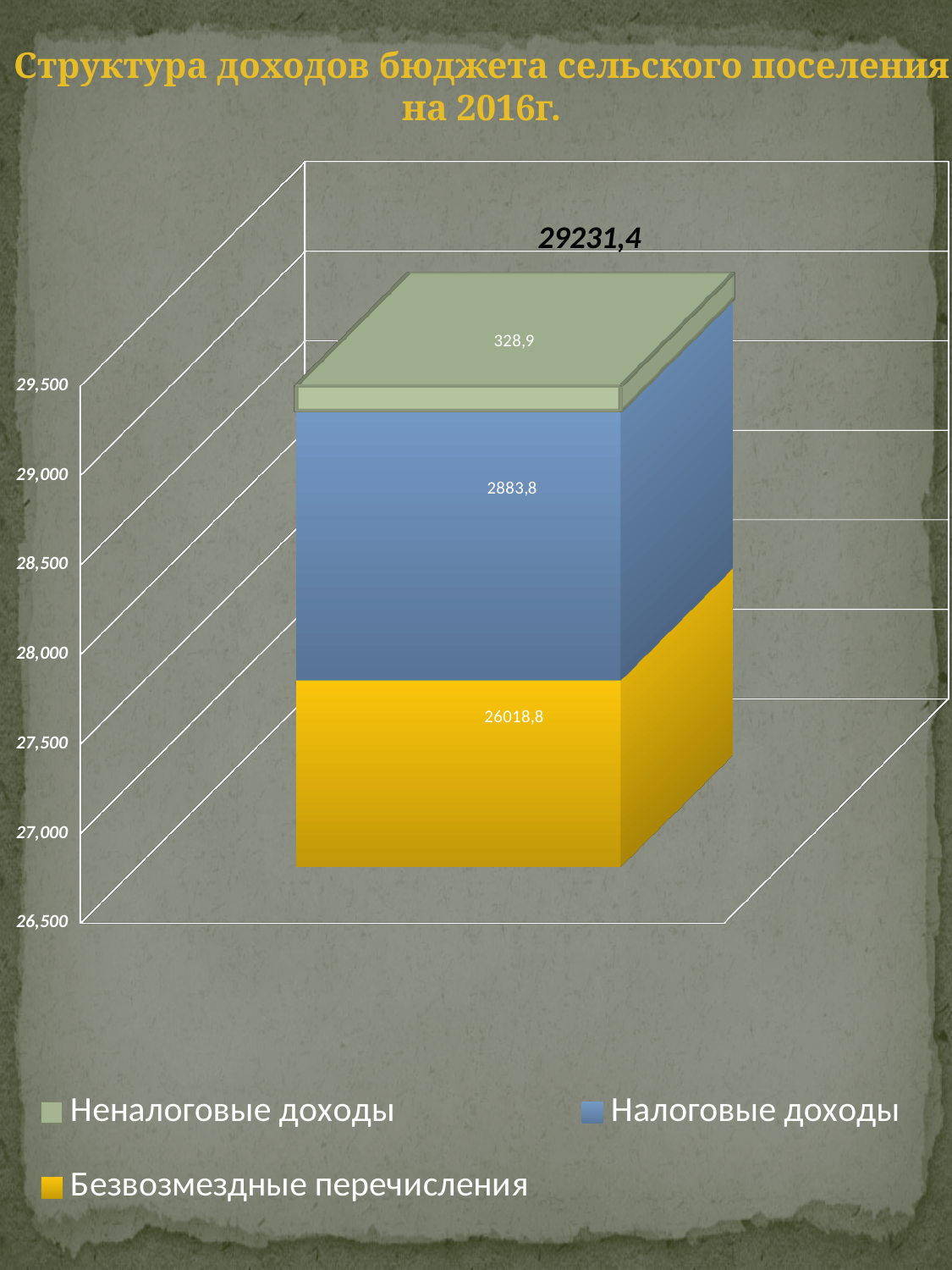
Which series has the smallest value? Неналоговые доходы What is the value for Налоговые доходы? 2883,8 What kind of chart is shown on the slide? Stacked bar chart What is the title of the chart? Структура доходов бюджета сельского поселения на 2016г. What is the difference between Налоговые доходы and Неналоговые доходы? 2554,9 What is the value for Безвозмездные перечисления? 26018,8 Which is larger, Налоговые доходы or Неналоговые доходы? Налоговые доходы Which colour represents Безвозмездные перечисления in the legend? Yellow Which series has the largest value? Безвозмездные перечисления How many series does the legend list? 3 What is the value for Неналоговые доходы? 328,9 What total is printed above the stacked bar? 29231,4